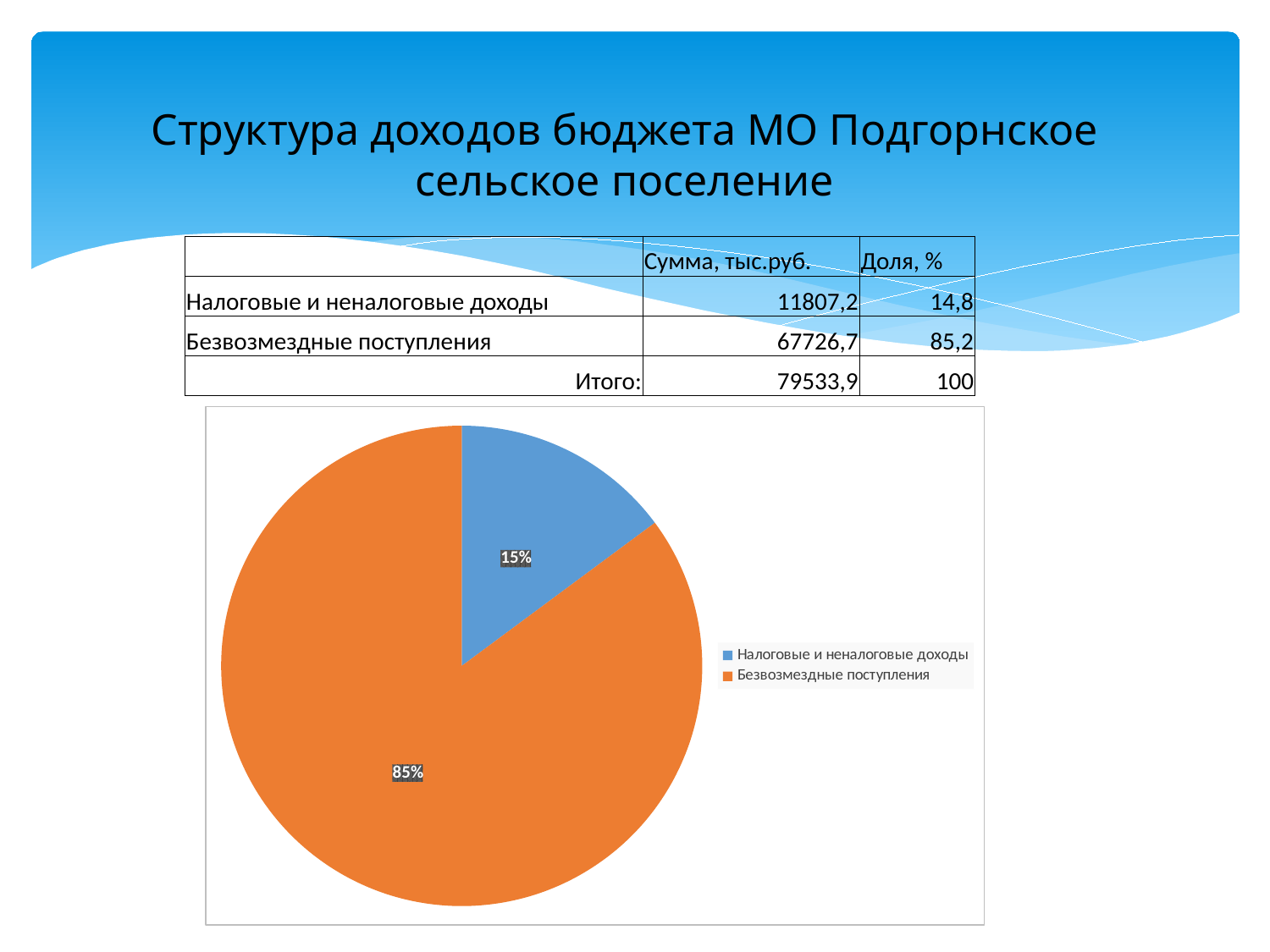
What share of the pie does the slice for Безвозмездные поступления have? 85% Which slice is larger: Налоговые и неналоговые доходы or Безвозмездные поступления? Безвозмездные поступления What is the difference in percentage points between the Безвозмездные поступления slice and the Налоговые и неналоговые доходы slice? 70% How many slices does the pie chart have? 2 What colour is the slice for Безвозмездные поступления? orange What share of the pie does the slice for Налоговые и неналоговые доходы have? 15% Which category has the largest slice in the pie chart? Безвозмездные поступления How many entries does the legend of the pie chart list? 2 What colour is the slice for Налоговые и неналоговые доходы? blue Which category has the smallest slice in the pie chart? Налоговые и неналоговые доходы What kind of chart is shown on the slide? pie chart